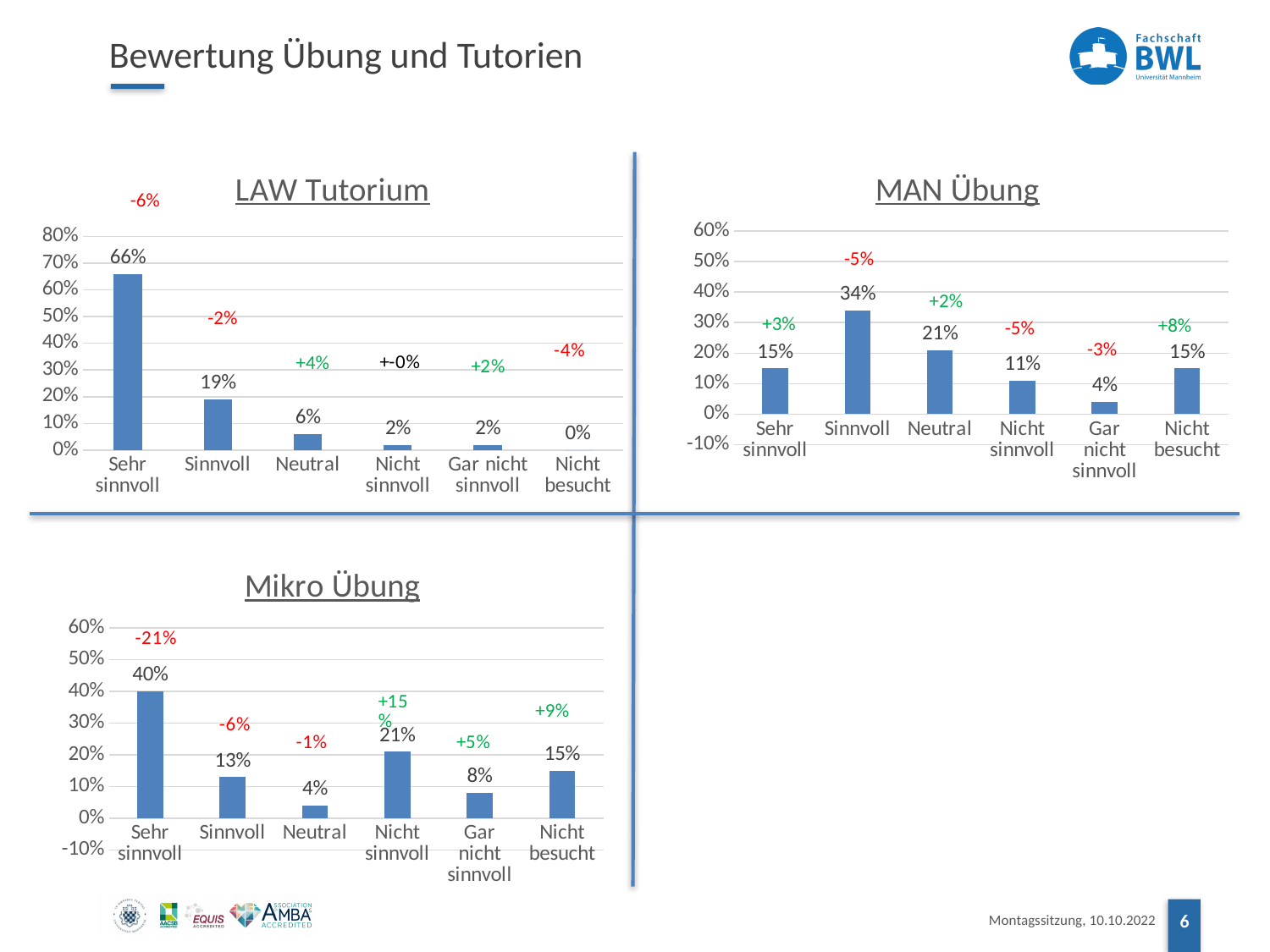
In the MAN Übung chart, what is the value for Sinnvoll? 34% In the LAW Tutorium chart, which category has the lowest value? Nicht besucht How many categories does the Mikro Übung chart show? 6 In the Mikro Übung chart, which category has the lowest value? Neutral In the LAW Tutorium chart, what change is shown in red above the Sehr sinnvoll bar? -6% In the MAN Übung chart, which is larger, Neutral or Nicht sinnvoll? Neutral In the Mikro Übung chart, what is the difference between Sehr sinnvoll and Nicht besucht? 25% What kind of chart is the MAN Übung chart? Bar chart In the LAW Tutorium chart, what is the difference between Sehr sinnvoll and Sinnvoll? 47% In the MAN Übung chart, which category has the highest value? Sinnvoll In the LAW Tutorium chart, what is the value for Sehr sinnvoll? 66% In the Mikro Übung chart, what is the value for Nicht sinnvoll? 21%